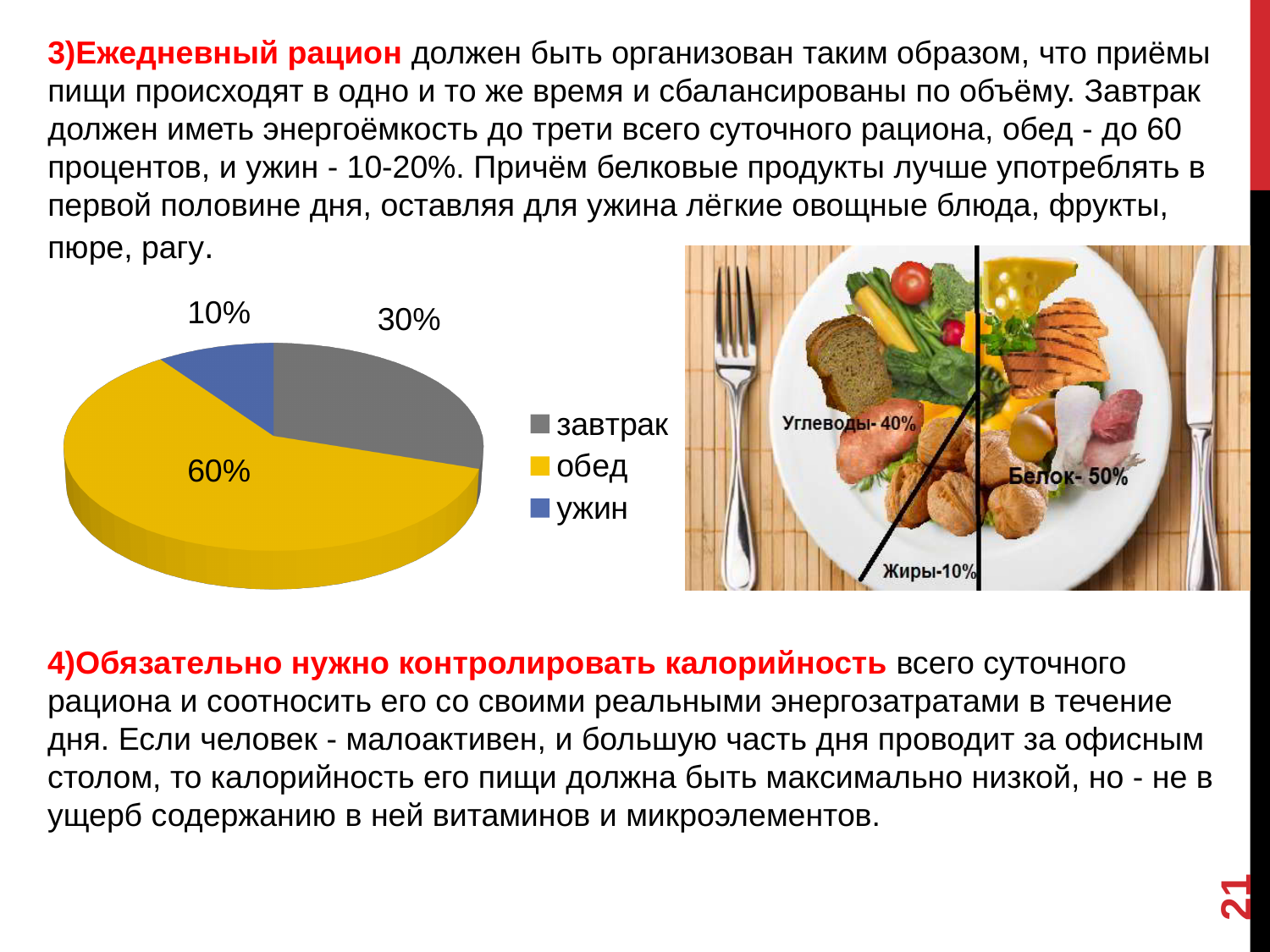
What is the difference in percentage points between завтрак and ужин in the pie chart? 20 What share of the pie chart does обед (lunch) take? 60% Which meal has the smallest slice in the pie chart? ужин What share of the pie chart does ужин (dinner) take? 10% Which meal has the largest slice in the pie chart? обед How many entries does the pie chart legend list? 3 What type of chart is shown on the slide? pie chart What share of the pie chart does завтрак (breakfast) take? 30% How many slices does the pie chart have? 3 What is the difference in percentage points between обед and завтрак in the pie chart? 30 Which slice is larger in the pie chart, завтрак or ужин? завтрак What colour is the обед slice in the pie chart? yellow